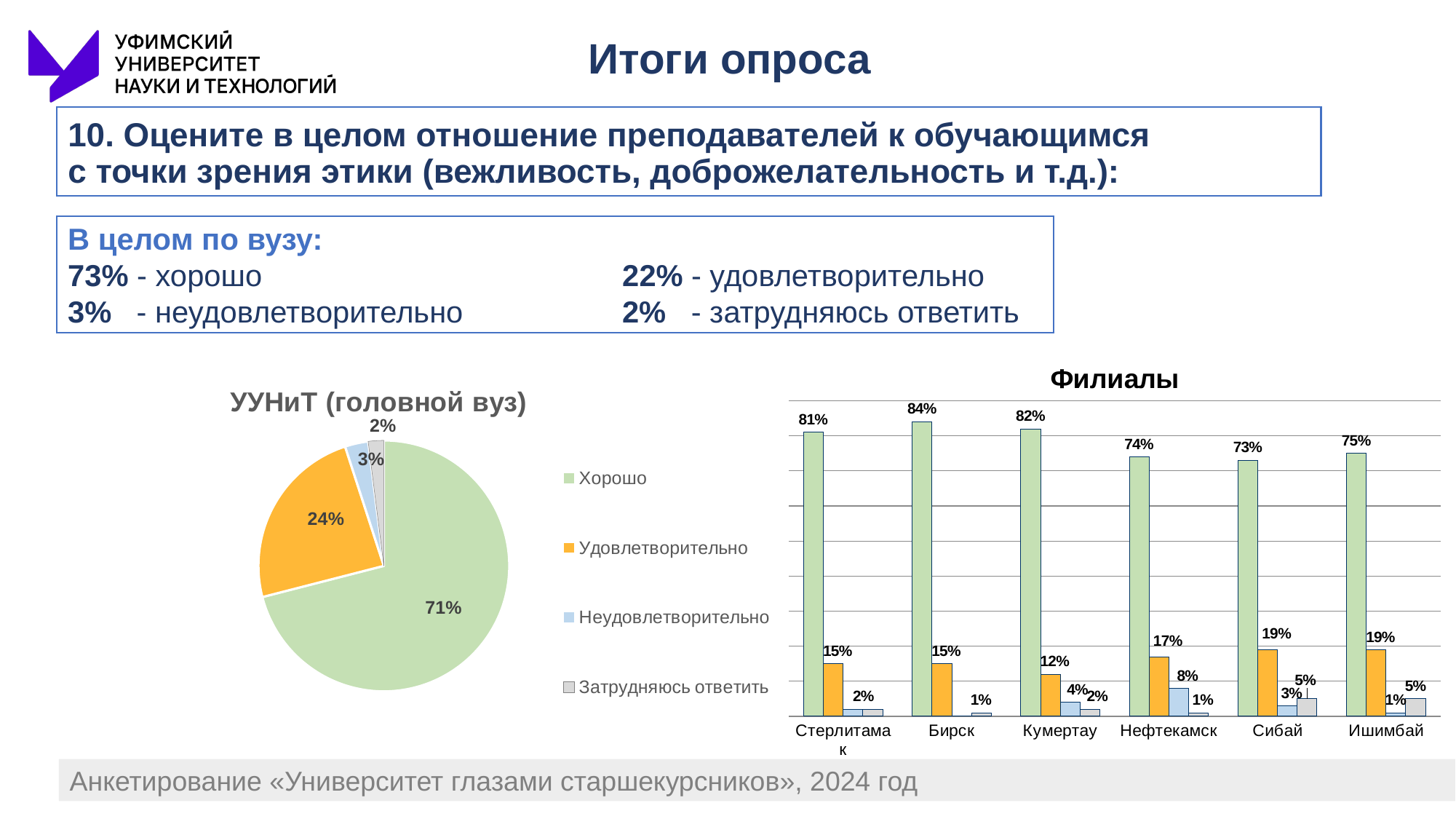
In the chart titled Филиалы, which branch has the highest Хорошо value? Бирск In the pie chart titled УУНиТ (головной вуз), what is the value for Удовлетворительно? 24% What kind of chart is the one titled Филиалы? Bar chart In the chart titled Филиалы, what is the Хорошо value for Бирск? 84% In the chart titled Филиалы, which is larger: the Удовлетворительно value for Кумертау or for Нефтекамск? Нефтекамск In the chart titled Филиалы, which branch has the lowest Хорошо value? Сибай How many entries does the legend of the pie chart УУНиТ (головной вуз) list? 4 In the pie chart titled УУНиТ (головной вуз), what share of the pie is the Хорошо slice? 71% How many branches are shown on the x axis of the chart titled Филиалы? 6 In the chart titled Филиалы, which branch has the highest Неудовлетворительно value? Нефтекамск In the chart titled Филиалы, what is the difference between the Хорошо values for Бирск and Сибай? 11 percentage points In the pie chart titled УУНиТ (головной вуз), which slice is the smallest? Затрудняюсь ответить